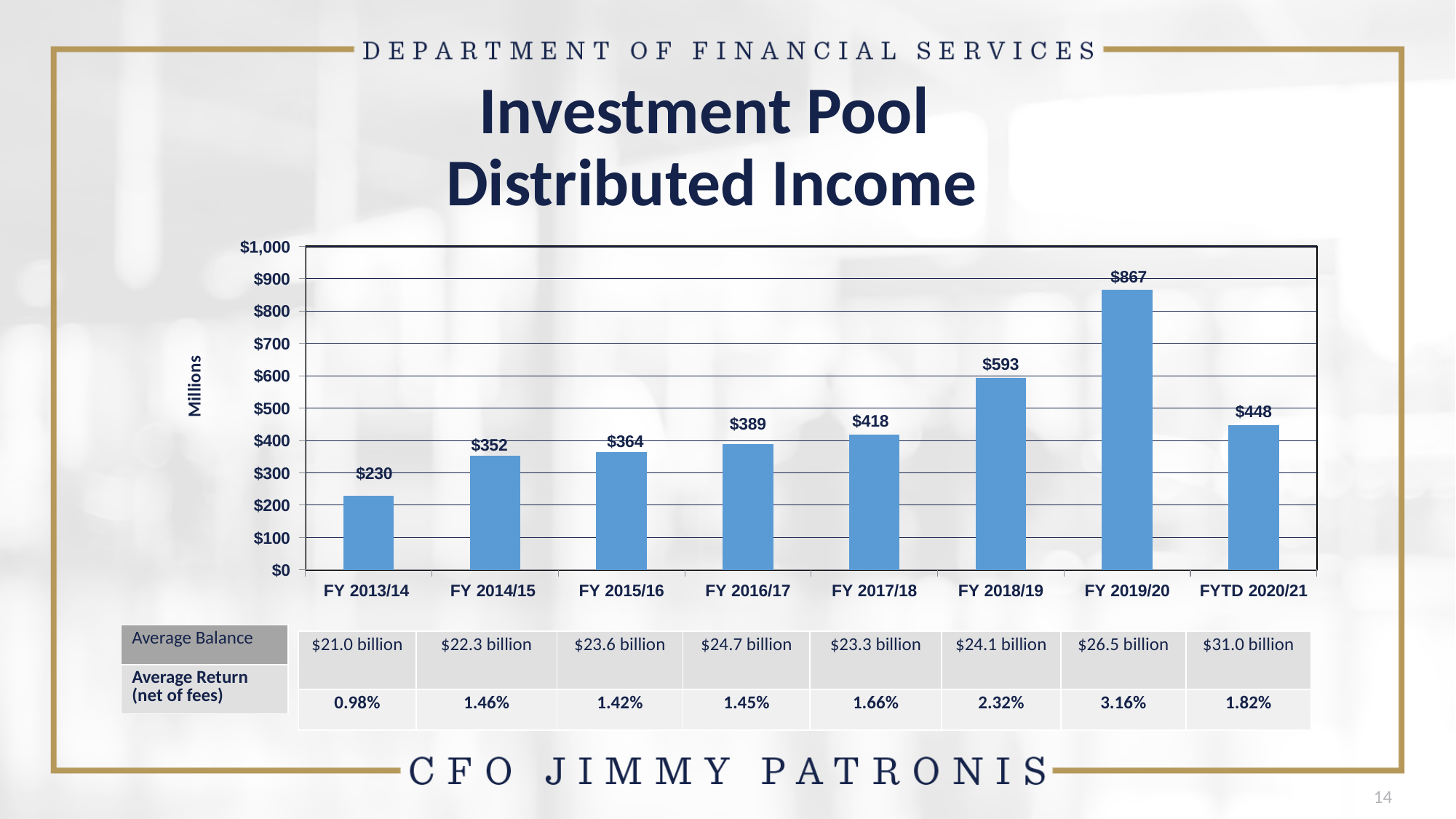
Which is larger, the distributed income for FY 2016/17 or FY 2017/18? FY 2017/18 Which fiscal year has the highest distributed income? FY 2019/20 Is the value for FY 2018/19 greater or less than $500? greater What is the distributed income value for FYTD 2020/21? $448 What is the distributed income value for FY 2019/20? $867 What is the difference between the distributed income for FY 2019/20 and FY 2018/19? $274 What unit is shown on the vertical axis label of the chart? Millions Which fiscal year has the lowest distributed income? FY 2013/14 What is the distributed income value for FY 2013/14? $230 What kind of chart is shown on the slide? bar chart How many fiscal years are shown on the chart? 8 Do the distributed income values rise or fall from FY 2013/14 to FY 2019/20? rise